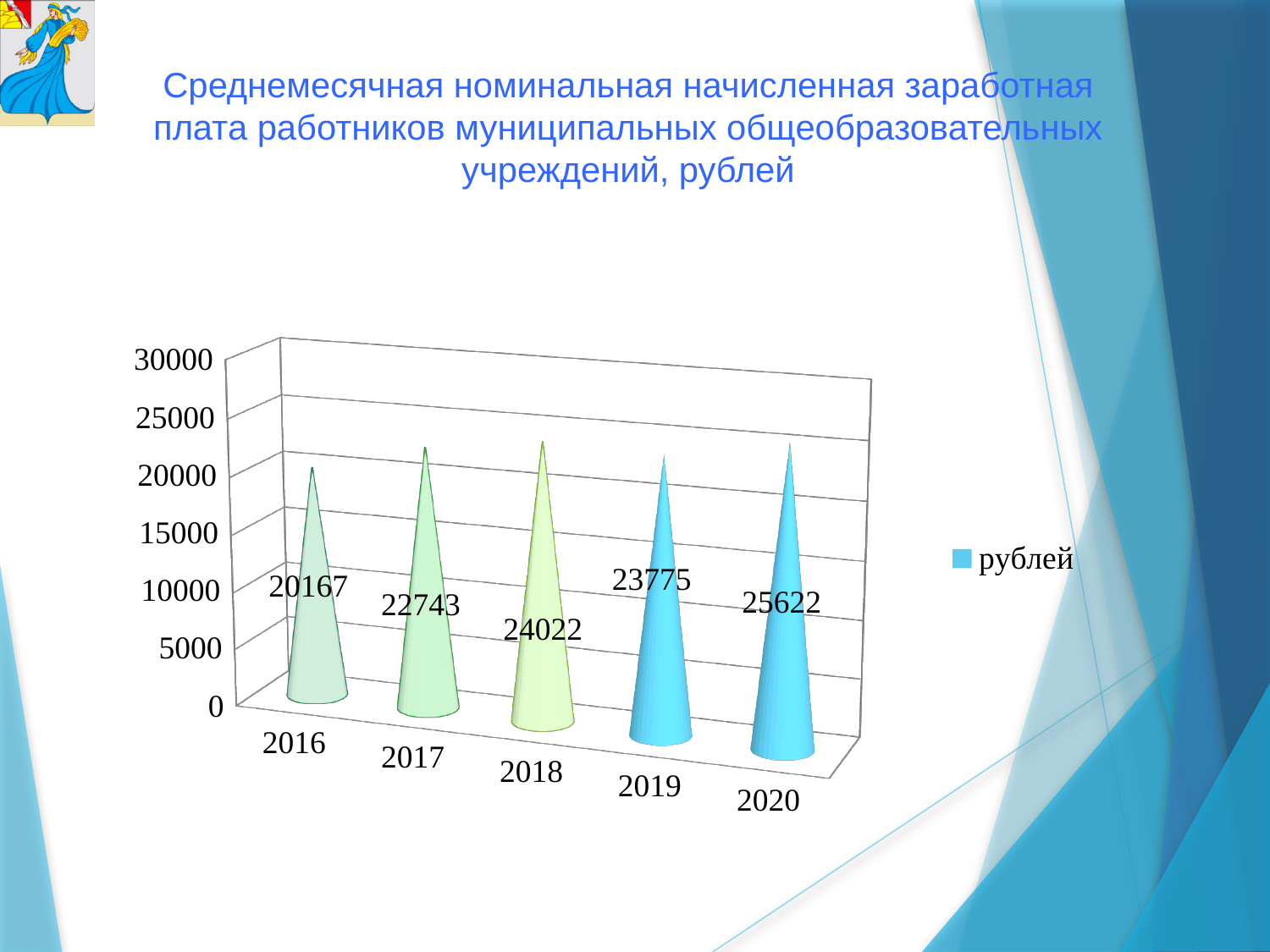
What is the difference between the values for 2020 and 2016? 5455 What is the value for 2018? 24022 How many series does the legend list? 1 What kind of chart is shown? bar chart Which year has the lowest value? 2016 Which is larger, the value for 2017 or the value for 2019? 2019 What is the value for 2016? 20167 What is the difference between the values for 2019 and 2017? 1032 Do the values rise or fall from 2016 to 2020? rise What is the value for 2020? 25622 Which year has the highest value? 2020 How many years are shown on the x axis? 5